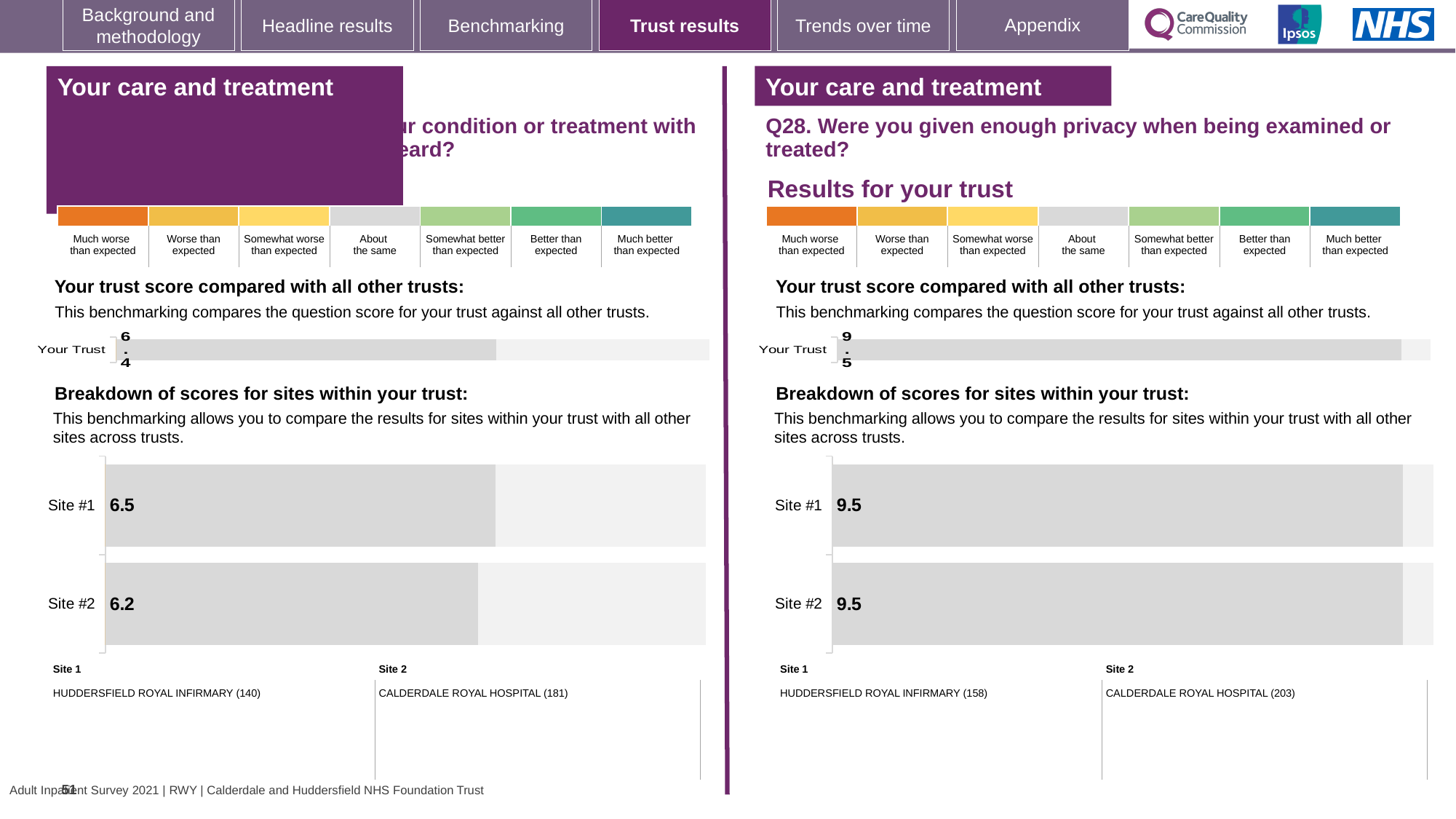
On the left-hand 'Breakdown of scores for sites within your trust' chart, which site has the higher score? Site #1 On the right-hand (Q28) 'Your trust score compared with all other trusts' chart, what is the score for Your Trust? 9.5 On the right-hand (Q28) 'Breakdown of scores for sites within your trust' chart, what is the score for Site #2? 9.5 On the left-hand 'Your trust score compared with all other trusts' chart, what is the score for Your Trust? 6.4 On the right-hand (Q28) 'Breakdown of scores for sites within your trust' chart, what is the difference between the Site #1 and Site #2 scores? 0 What type of chart is used for the 'Breakdown of scores for sites within your trust' on the left-hand side of the slide? Bar chart On the left-hand 'Breakdown of scores for sites within your trust' chart, what is the score for Site #1? 6.5 Is the Site #1 score on the right-hand (Q28) breakdown chart larger or smaller than the Site #1 score on the left-hand breakdown chart? Larger On the left-hand 'Breakdown of scores for sites within your trust' chart, what is the score for Site #2? 6.2 How many sites are shown on the right-hand (Q28) 'Breakdown of scores for sites within your trust' chart? 2 On the left-hand 'Breakdown of scores for sites within your trust' chart, what is the difference between the Site #1 and Site #2 scores? 0.3 Which hospital is listed as Site 2 beneath the right-hand (Q28) breakdown chart? CALDERDALE ROYAL HOSPITAL (203)